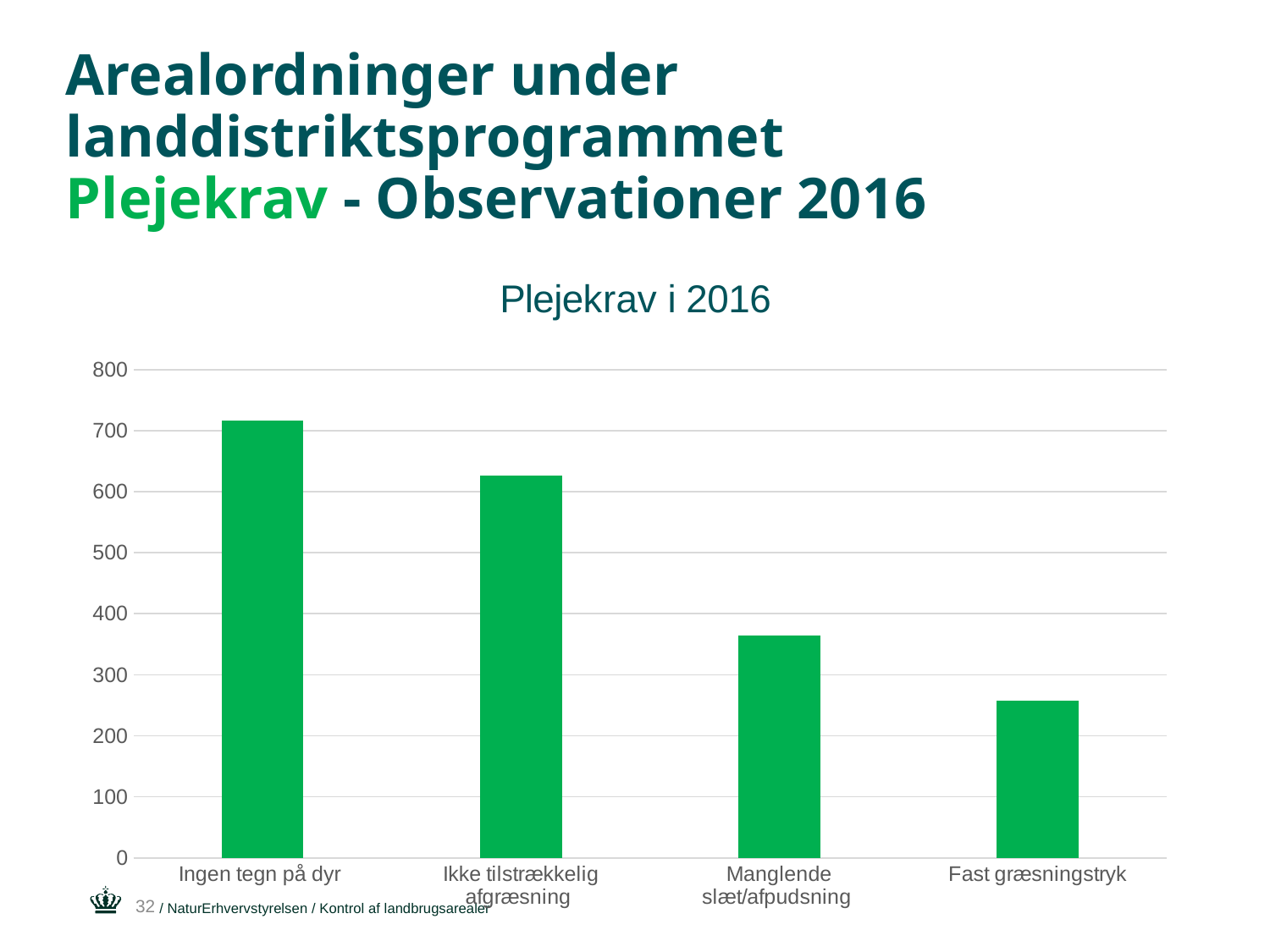
Is the value for Ikke tilstrækkelig afgræsning greater or less than 600? greater What is the title of the chart? Plejekrav i 2016 Is the value for Manglende slæt/afpudsning greater or less than 400? less Which category has the lowest value? Fast græsningstryk What is the highest value shown on the vertical axis? 800 Is the value for Ingen tegn på dyr greater or less than 700? greater Which category has the highest value? Ingen tegn på dyr How many categories are shown on the x axis of the chart? 4 Do the values rise or fall from left to right along the x axis? fall What kind of chart is shown on the slide? bar chart Which is larger, the value for Ikke tilstrækkelig afgræsning or the value for Manglende slæt/afpudsning? Ikke tilstrækkelig afgræsning